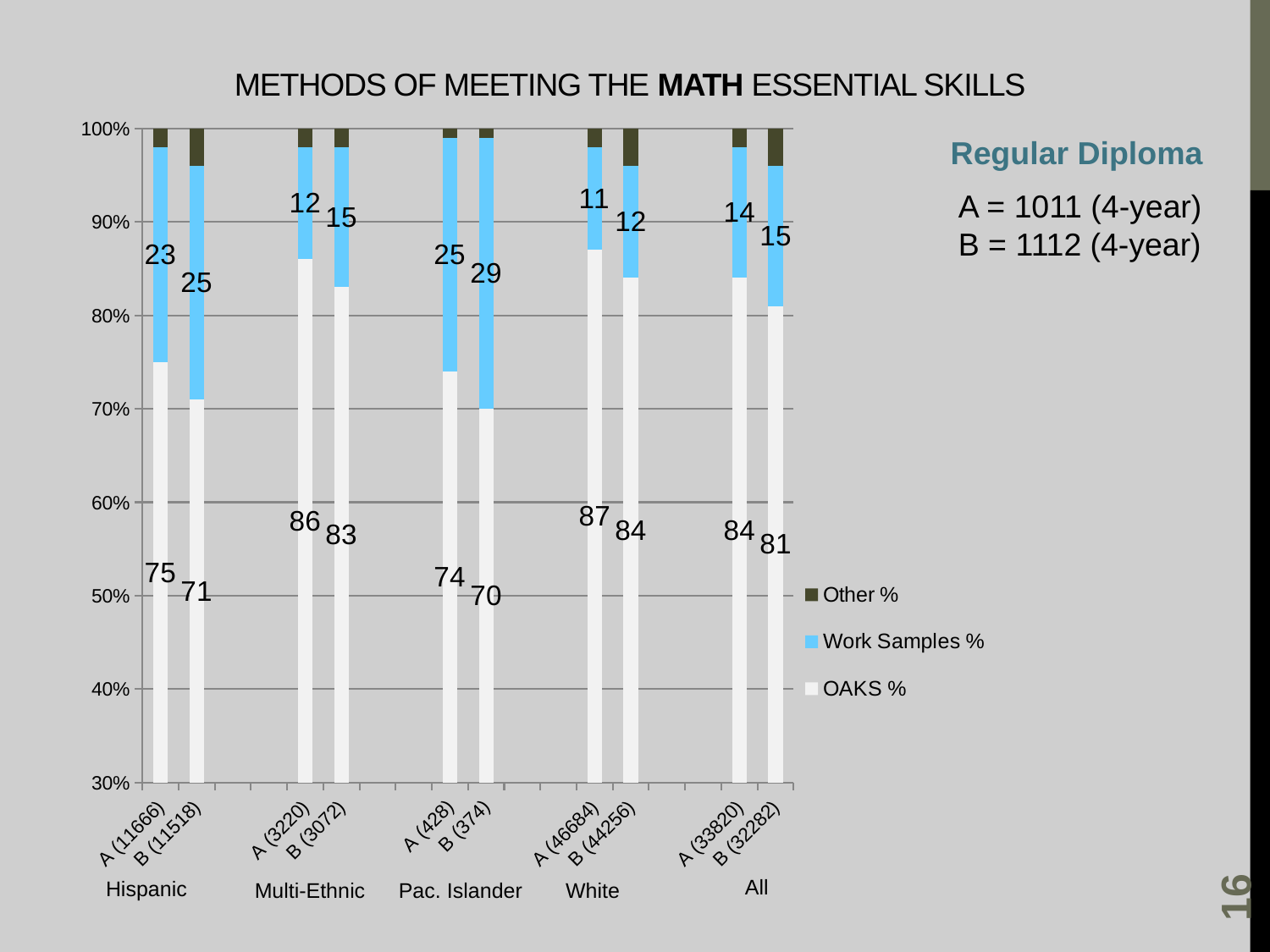
What kind of chart is shown on the slide? Stacked bar chart Which has a larger Work Samples % value, Hispanic A (11666) or Multi-Ethnic A (3220)? Hispanic A (11666) Which series is shown in light blue in the legend? Work Samples % How many series does the legend list? 3 What is the OAKS % value for the White A (46684) bar? 87 How many bars are plotted in the chart? 10 What is the Work Samples % value for the Pac. Islander B (374) bar? 29 What is the difference between the OAKS % values for Hispanic A (11666) and Hispanic B (11518)? 4 Which bar has the lowest OAKS % value? Pac. Islander B (374) Which bar has the highest OAKS % value? White A (46684) Which bar has the highest Work Samples % value? Pac. Islander B (374) What is the OAKS % value for the All B (32282) bar? 81